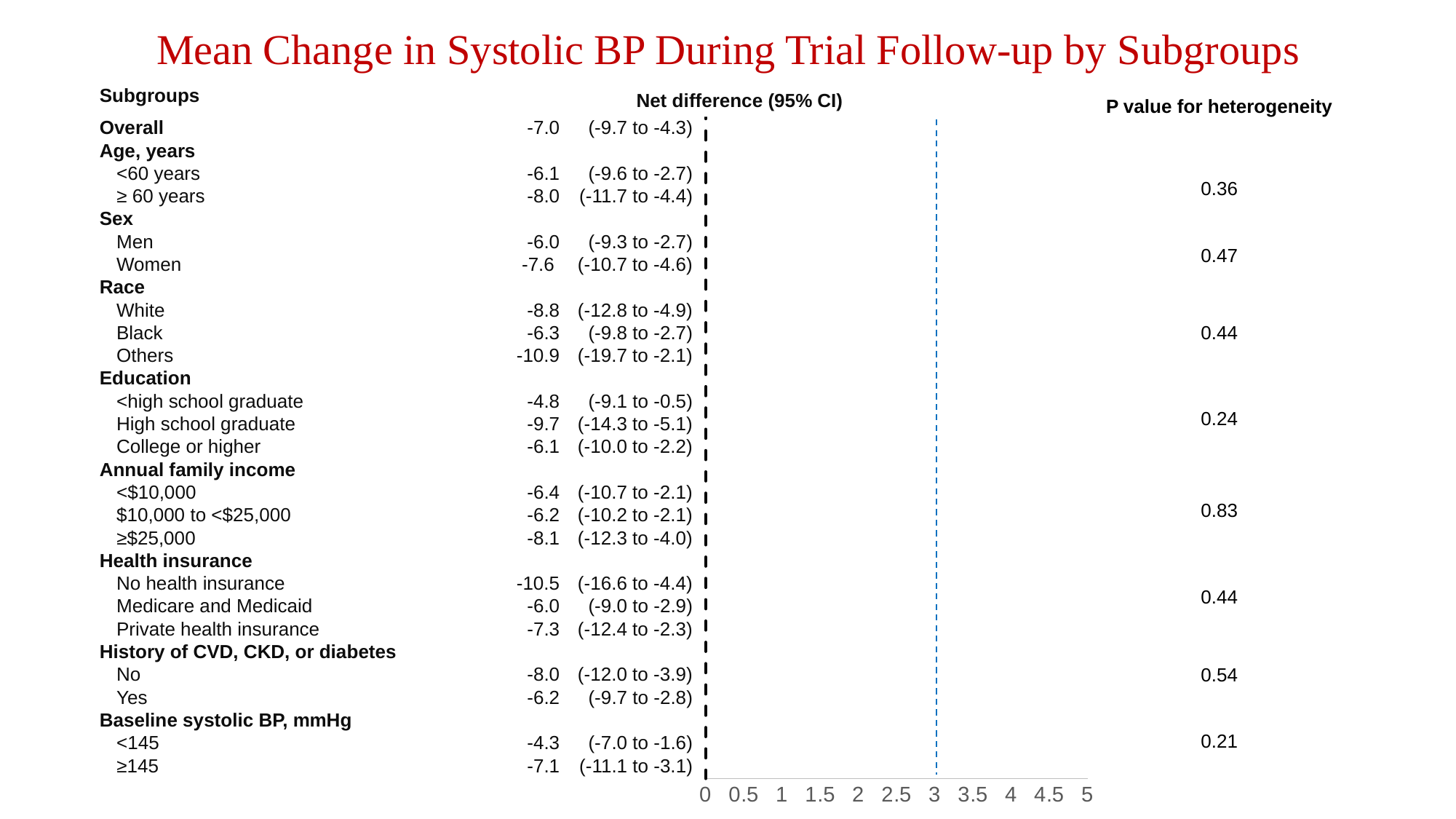
Which has a larger reduction in systolic BP: No health insurance or Private health insurance? No health insurance What is the 95% CI for the net difference in the Women subgroup? (-10.7 to -4.6) What is the title of the slide? Mean Change in Systolic BP During Trial Follow-up by Subgroups What is the P value for heterogeneity for the Baseline systolic BP subgroups? 0.21 How many subgroup categories (bold headings, excluding Overall) are listed on the slide? 8 Which subgroup has the most negative net difference (largest reduction) in systolic BP? Others (Race) What is the maximum value shown on the horizontal axis at the bottom of the chart? 5 What is the P value for heterogeneity for the Annual family income subgroups? 0.83 Which subgroup has the smallest reduction (least negative net difference) in systolic BP? <145 (Baseline systolic BP) What is the net difference for the High school graduate subgroup? -9.7 What is the net difference in systolic BP for the Overall group? -7.0 What is the difference between the net difference for Men (-6.0) and Women (-7.6)? 1.6